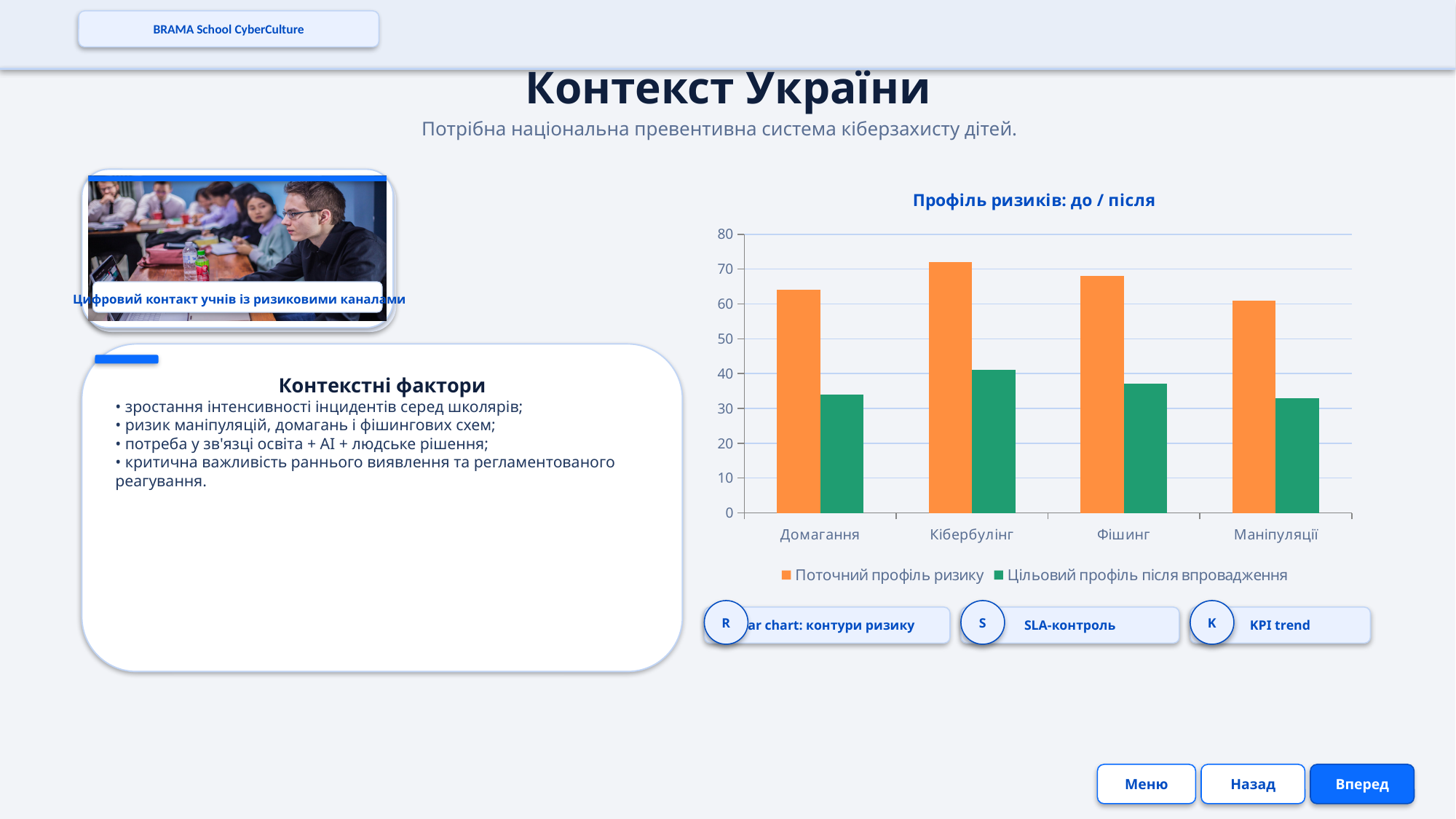
What kind of chart is shown on the slide? bar chart How many series does the chart legend list? 2 Which category has the highest value for 'Поточний профіль ризику'? Кібербулінг What is the title of the chart? Профіль ризиків: до / після Which category has the highest value for 'Цільовий профіль після впровадження'? Кібербулінг Which is larger for 'Поточний профіль ризику': Кібербулінг or Фішинг? Кібербулінг Is the value for 'Поточний профіль ризику' in Фішинг greater or less than 60? greater Is the value for 'Поточний профіль ризику' in Домагання greater or less than 60? greater Is the value for 'Цільовий профіль після впровадження' in Маніпуляції greater or less than 40? less How many categories are shown on the x axis of the chart? 4 Which is larger for 'Цільовий профіль після впровадження': Домагання or Кібербулінг? Кібербулінг Which colour represents the series 'Поточний профіль ризику'? orange